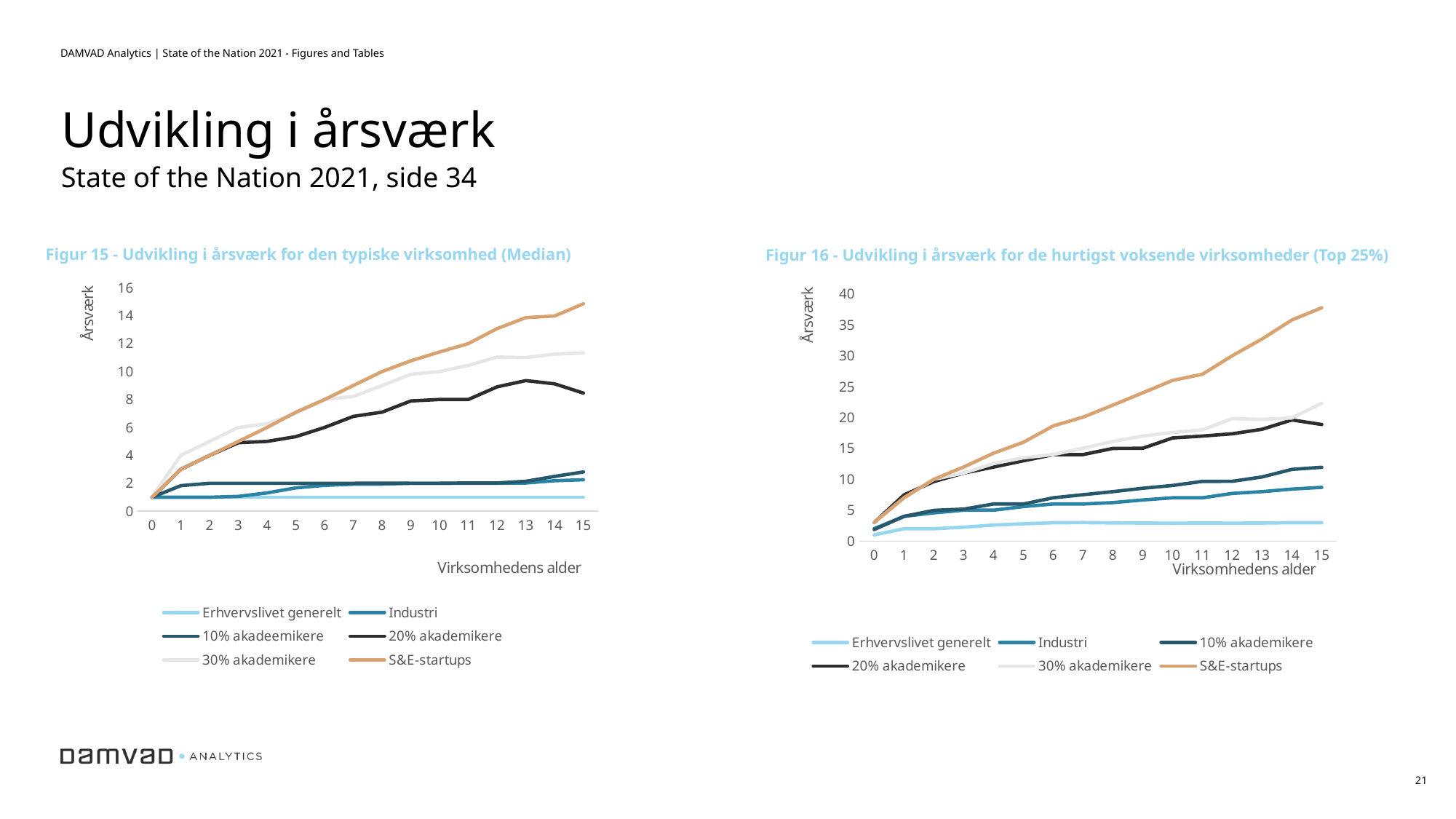
How many series does the legend of Figur 16 list? 6 In Figur 16, is the value for Erhvervslivet generelt at age 15 greater or less than 5? less In Figur 15, is the value for 20% akademikere at age 15 greater or less than 10? less In Figur 16, which series has the lowest value at age 15? Erhvervslivet generelt What is the label on the x axis of Figur 15? Virksomhedens alder In Figur 15, which series has the highest value at age 15? S&E-startups What kind of chart is Figur 15? line chart In Figur 15, how many points (ages) are shown along the x axis? 16 In Figur 16, does the S&E-startups line rise or fall as the firm's age increases from 0 to 15? rise In Figur 16, which is larger at age 15: 30% akademikere or 20% akademikere? 30% akademikere In Figur 16, is the value for S&E-startups at age 15 greater or less than 35? greater